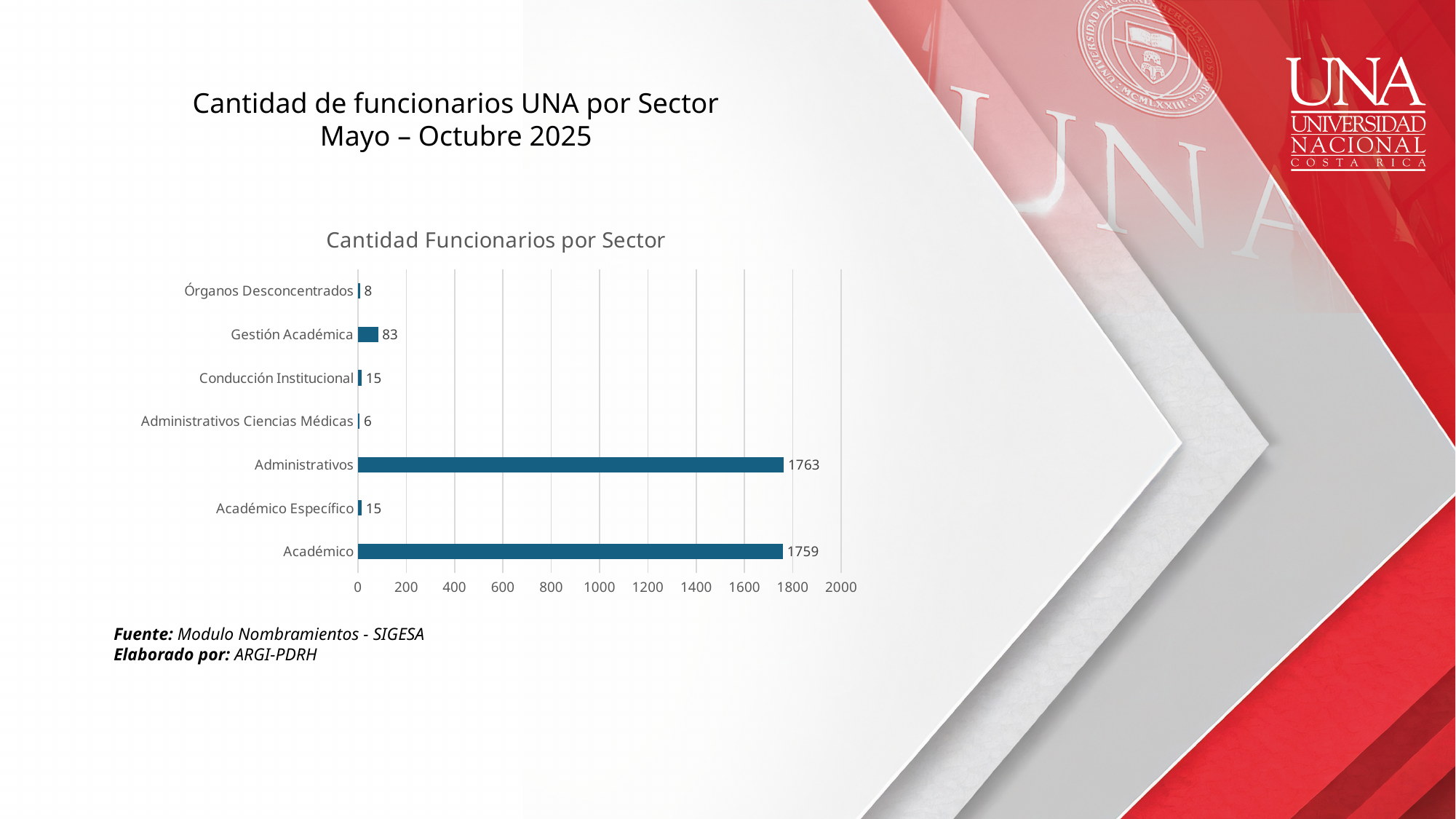
What kind of chart is shown on the slide? Bar chart Which sector has the highest value? Administrativos What is the value for Administrativos Ciencias Médicas? 6 What is the value for Académico? 1759 What is the title of the chart? Cantidad Funcionarios por Sector How many sectors are shown in the chart? 7 Which is larger, the value for Gestión Académica or the value for Órganos Desconcentrados? Gestión Académica What is the difference between the values for Gestión Académica and Conducción Institucional? 68 What is the difference between the values for Administrativos and Académico? 4 What is the value for Administrativos? 1763 Which sector has the lowest value? Administrativos Ciencias Médicas What is the value for Gestión Académica? 83